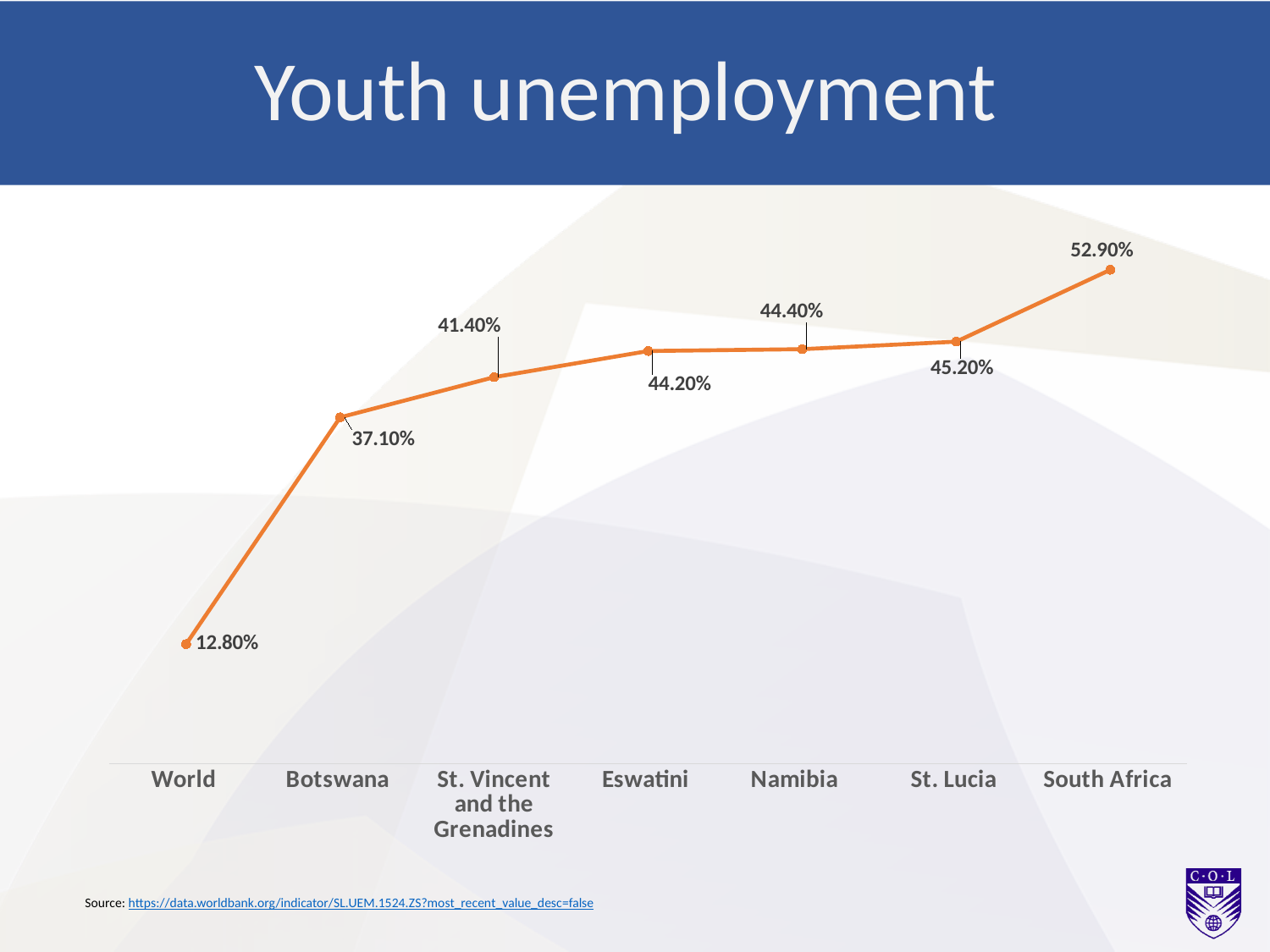
Which category has the highest youth unemployment value? South Africa What is the difference between the values for South Africa and World? 40.10% How many categories are plotted on the chart? 7 What is the youth unemployment value for South Africa? 52.90% What is the difference between the values for St. Lucia and Eswatini? 1.00% What is the youth unemployment value for St. Vincent and the Grenadines? 41.40% What kind of chart is shown on the slide? Line chart What is the youth unemployment value for Botswana? 37.10% Do the values rise or fall from left to right along the x axis? Rise Which has a larger value, Botswana or St. Lucia? St. Lucia What is the youth unemployment value for Namibia? 44.40% Which category has the lowest youth unemployment value? World